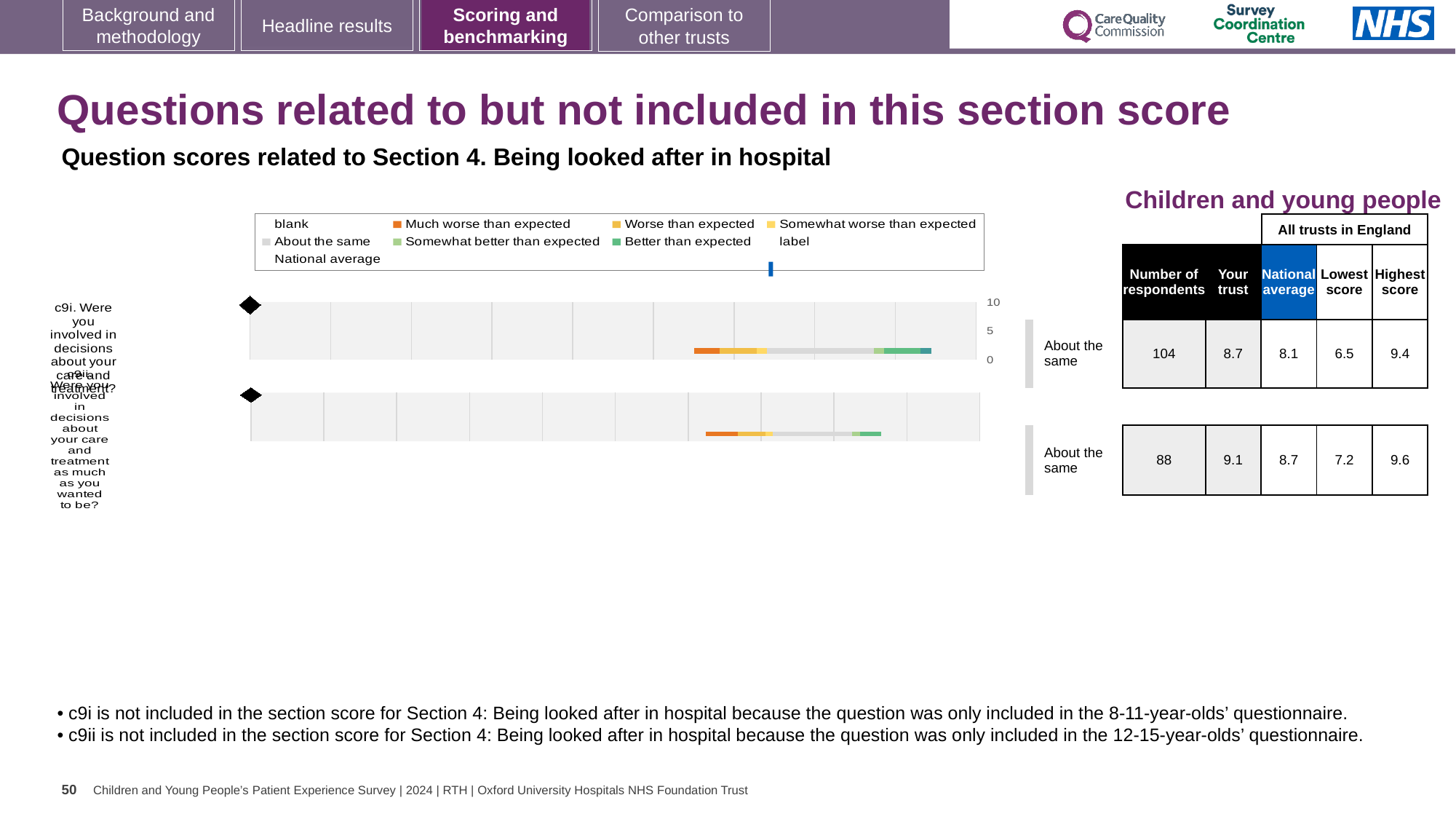
What is the national average score for c9i? 8.1 What is the difference between the 'Your trust' score and the national average for c9i? 0.6 What is the lowest score among all trusts in England for c9i? 6.5 In the table beside the chart, what is the 'Your trust' score for c9i? 8.7 How many questions (rows) are plotted in the chart? 2 What benchmark category label is shown next to both c9i and c9ii? About the same Which question has the higher 'Your trust' score, c9i or c9ii? c9ii How many respondents answered c9ii? 88 Which legend entry is represented by the blue marker in the chart legend? National average What is the difference between the highest score and the lowest score for c9ii? 2.4 What kind of chart is used to show the question scores for c9i and c9ii? bar chart In the table beside the chart, what is the 'Your trust' score for c9ii? 9.1